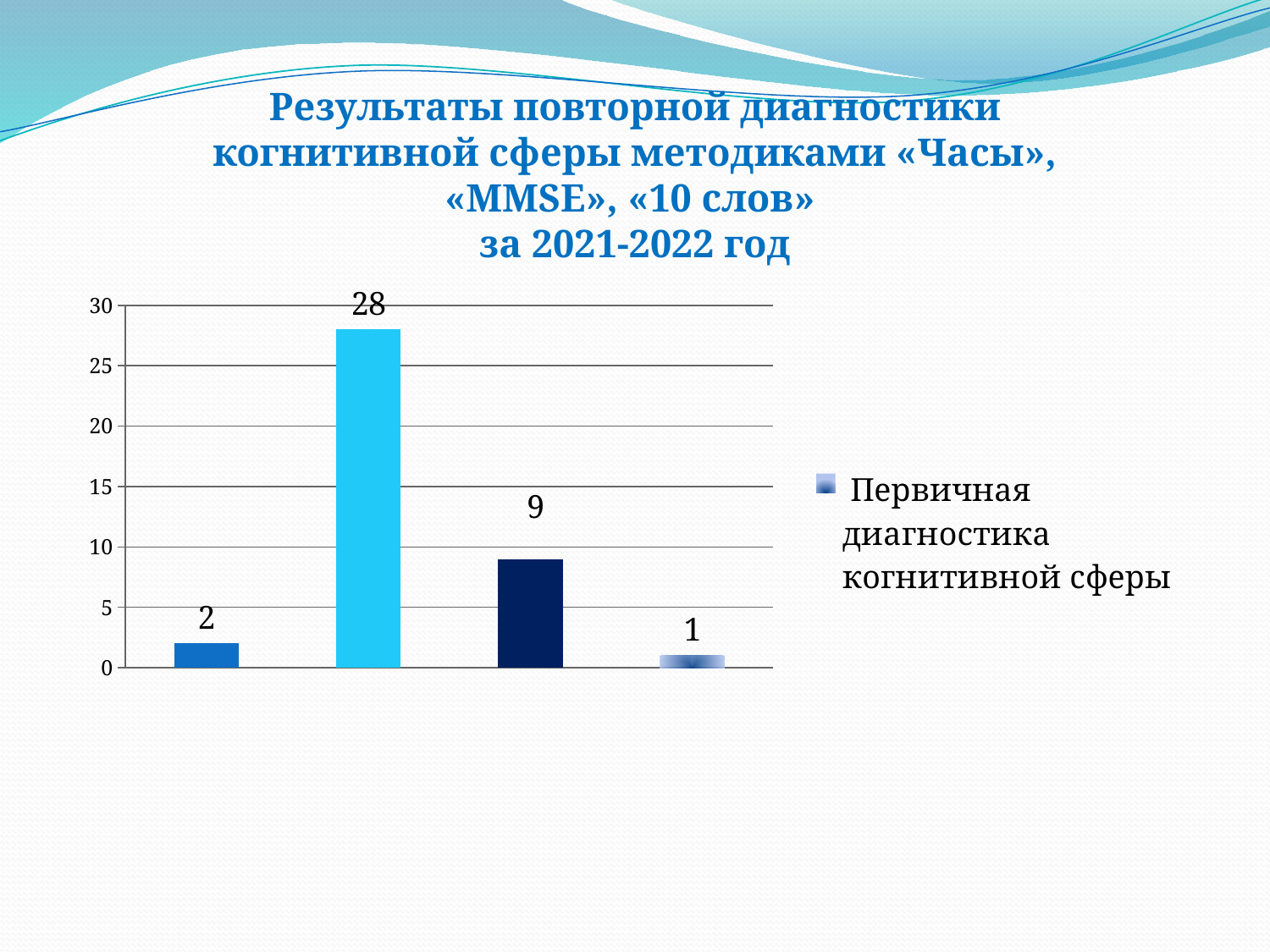
What is the difference between the tallest bar and the third bar? 19 Which bar has the highest value? the second (light cyan) bar, 28 What type of chart is shown on the slide? bar chart How many entries does the chart legend list? 1 What is the value of the fourth (rightmost) bar? 1 Which bar has the lowest value? the fourth (rightmost) bar, 1 What is the value of the third (dark navy) bar? 9 What is the legend entry shown next to the chart? Первичная диагностика когнитивной сферы What is the value of the second (light cyan) bar from the left? 28 Which is larger, the first bar or the third bar? the third bar How many bars are plotted in the chart? 4 What is the value of the first (leftmost) bar? 2